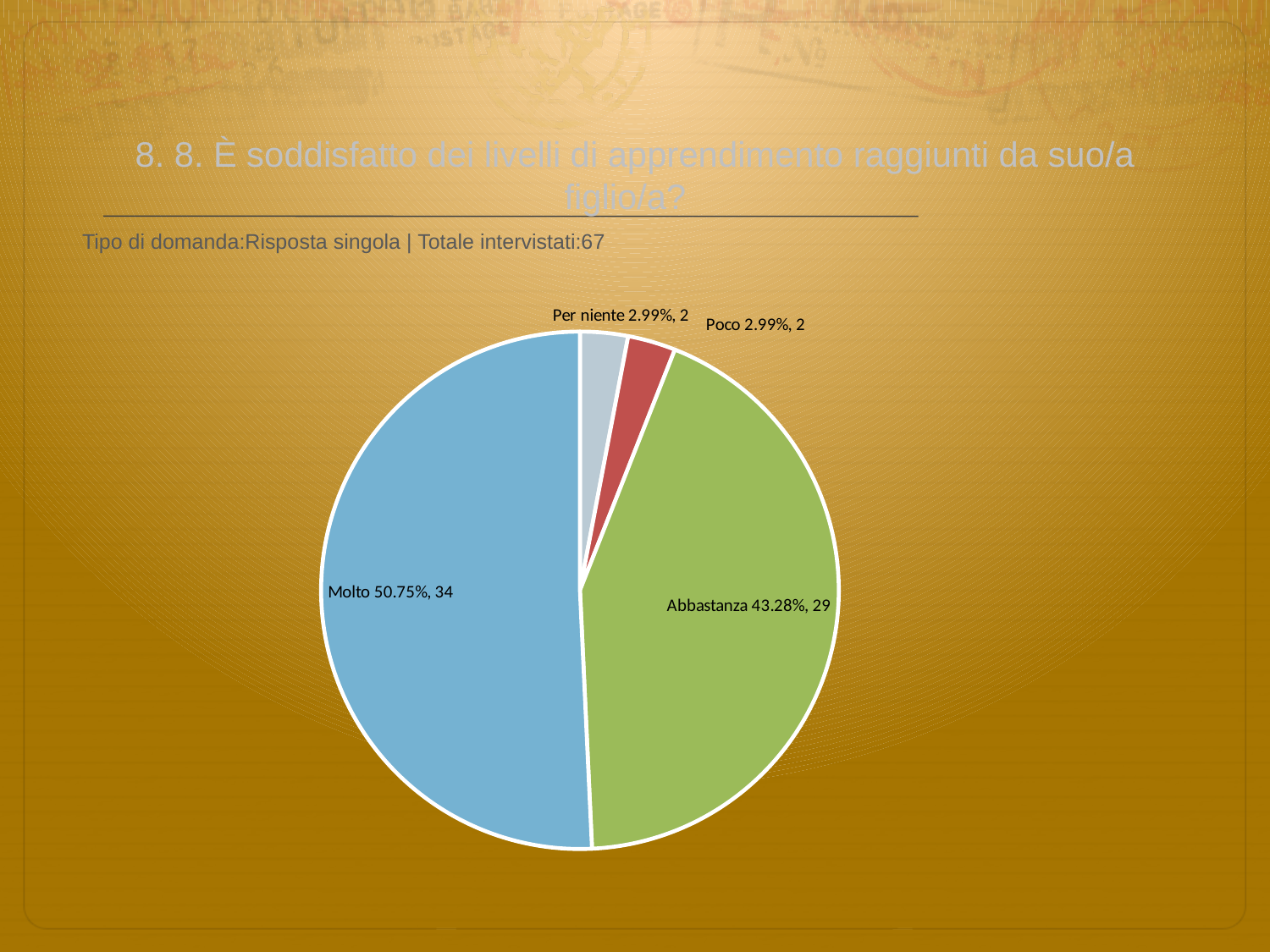
How many slices does the pie chart have? 4 What is the difference in respondent count between Molto and Abbastanza? 5 How many respondents answered Abbastanza? 29 How many respondents answered Molto? 34 What percentage share does the Abbastanza slice have? 43.28% What is the total number of respondents stated on the slide? 67 How many respondents answered Poco? 2 Which category has the largest slice? Molto What percentage share does the Per niente slice have? 2.99% What percentage share does the Molto slice have? 50.75% Which is larger, the Abbastanza slice or the Poco slice? Abbastanza What kind of chart is shown on the slide? pie chart